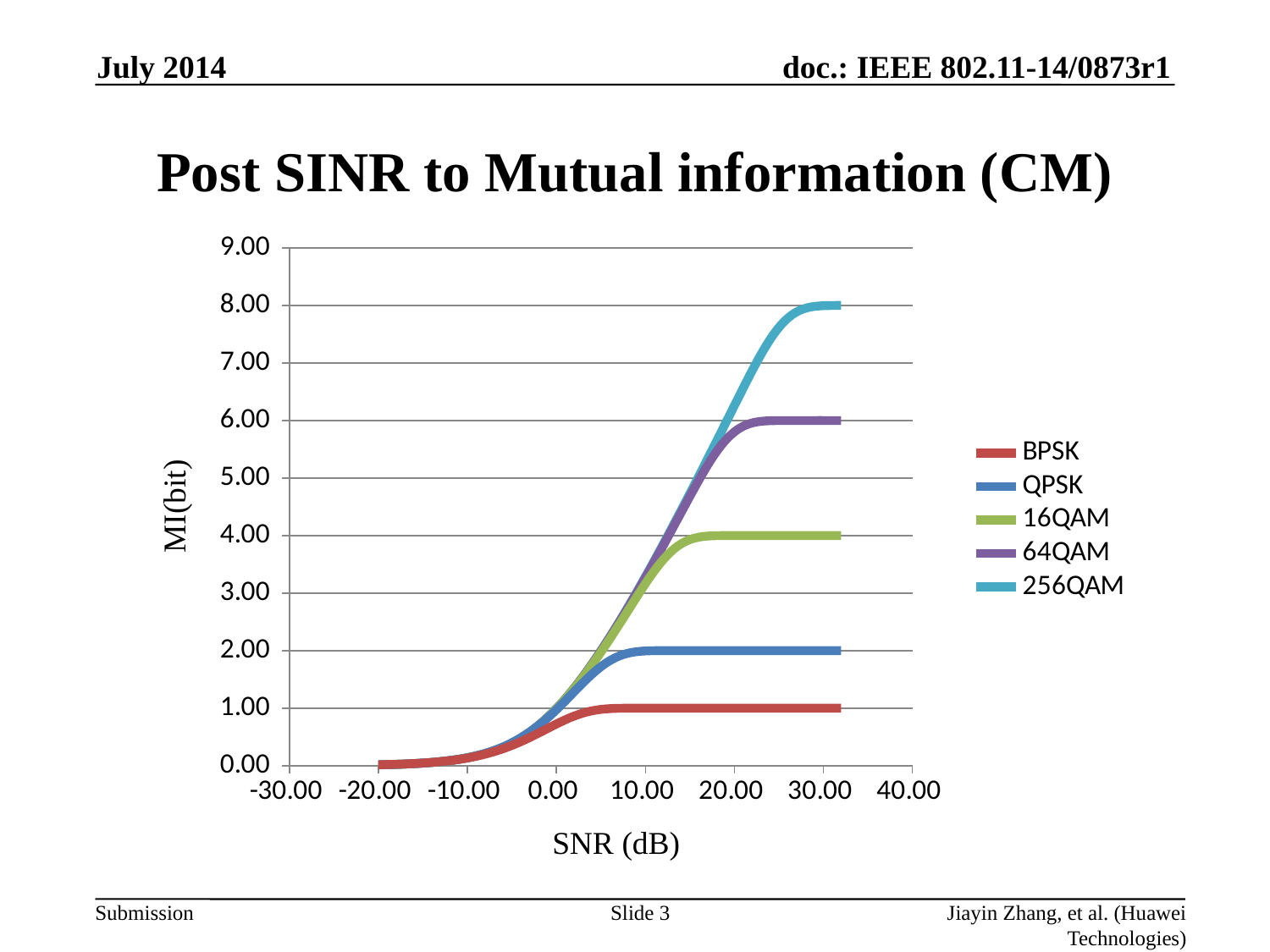
What is the difference between the plateau MI values of 256QAM and 64QAM? 2.00 What is the title of the chart? Post SINR to Mutual information (CM) At what MI value does the 256QAM curve plateau? 8.00 At an SNR of 30.00 dB, which series has the larger MI, 64QAM or 16QAM? 64QAM Which series has the lowest maximum MI value? BPSK At what MI value does the 16QAM curve plateau? 4.00 At what MI value does the BPSK curve plateau? 1.00 Which series reaches the highest MI value? 256QAM Is the MI value for 256QAM at an SNR of 30.00 dB greater or less than 7.00? greater What kind of chart is shown on the slide? line chart What is the label of the x axis? SNR (dB) How many series does the legend list? 5